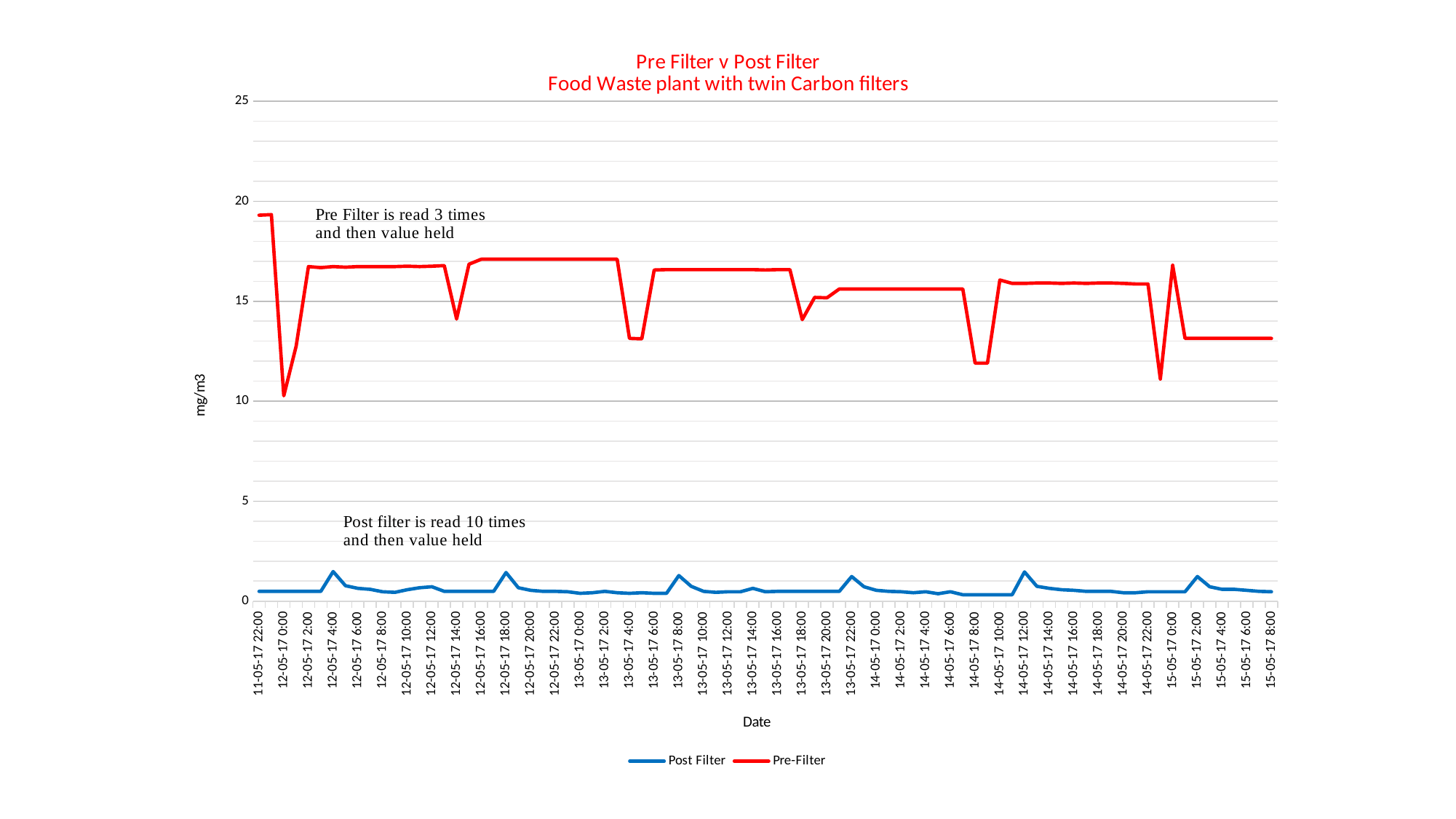
What kind of chart is shown on the slide? Line chart What is the label on the vertical axis? mg/m3 How many series does the legend list? 2 Is the Pre-Filter value at 11-05-17 22:00 greater or less than 15? greater What is the title of the chart? Pre Filter v Post Filter Food Waste plant with twin Carbon filters Is the Post Filter value at 12-05-17 4:00 greater or less than 5? less Is the Pre-Filter value at 12-05-17 0:00 greater or less than 15? less Does the Pre-Filter value rise or fall between 11-05-17 22:00 and 12-05-17 0:00? fall At 13-05-17 8:00, which series has the larger value, Pre-Filter or Post Filter? Pre-Filter